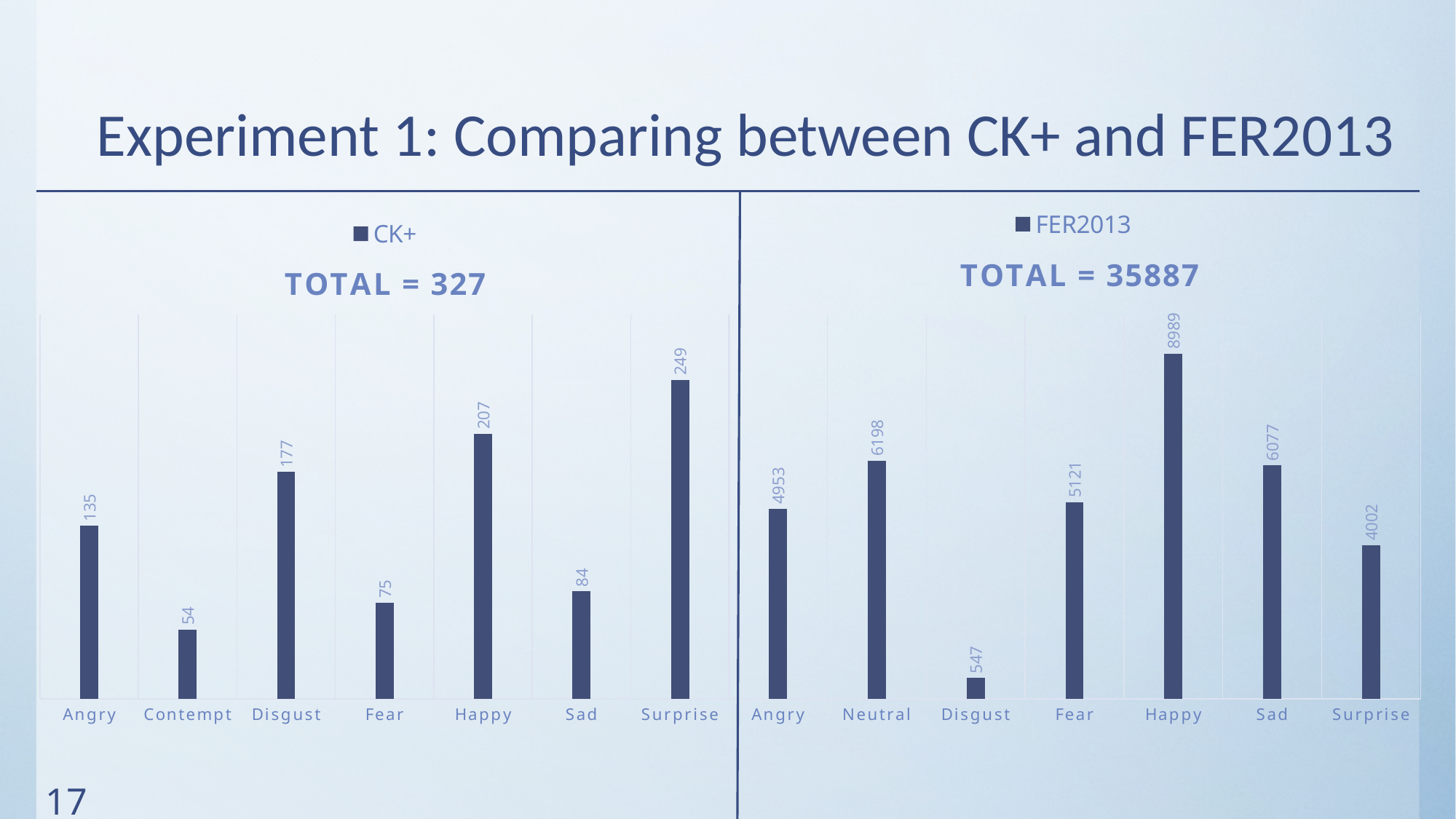
In the CK+ chart on the left, what is the difference between Happy and Angry? 72 In the CK+ chart on the left, what is the value for Disgust? 177 What is the legend entry for the chart on the left? CK+ In the CK+ chart on the left, which category has the lowest value? Contempt How many categories are shown in the CK+ chart on the left? 7 In the CK+ chart on the left, which category has the highest value? Surprise In the FER2013 chart on the right, what is the difference between Happy and Sad? 2912 What kind of chart is the FER2013 chart on the right? Bar chart In the FER2013 chart on the right, which category has the lowest value? Disgust In the FER2013 chart on the right, what is the value for Neutral? 6198 In the FER2013 chart on the right, which is larger, Fear or Angry? Fear What total is stated above the FER2013 chart on the right? TOTAL = 35887